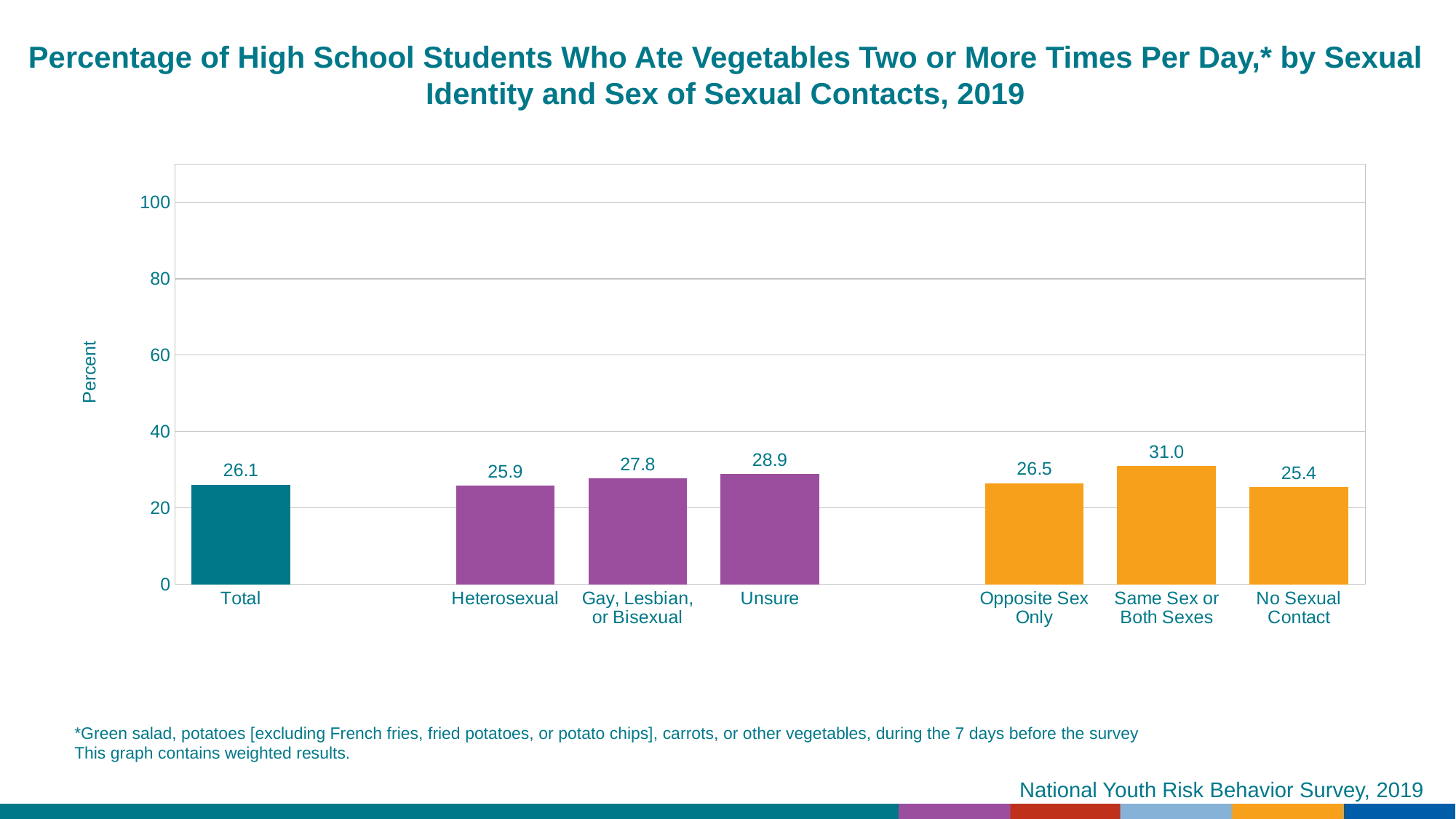
Which category has the highest value? Same Sex or Both Sexes Which category has the lowest value? No Sexual Contact What is the value for Same Sex or Both Sexes? 31.0 What is the label of the y axis? Percent What kind of chart is shown on the slide? bar chart What is the difference between the values for Unsure and Heterosexual? 3.0 What is the value for Gay, Lesbian, or Bisexual? 27.8 Is the value for Same Sex or Both Sexes greater or less than 40? less Which is larger, the value for Opposite Sex Only or the value for No Sexual Contact? Opposite Sex Only What is the value for Total? 26.1 How many categories are shown in the chart? 7 What is the value for No Sexual Contact? 25.4